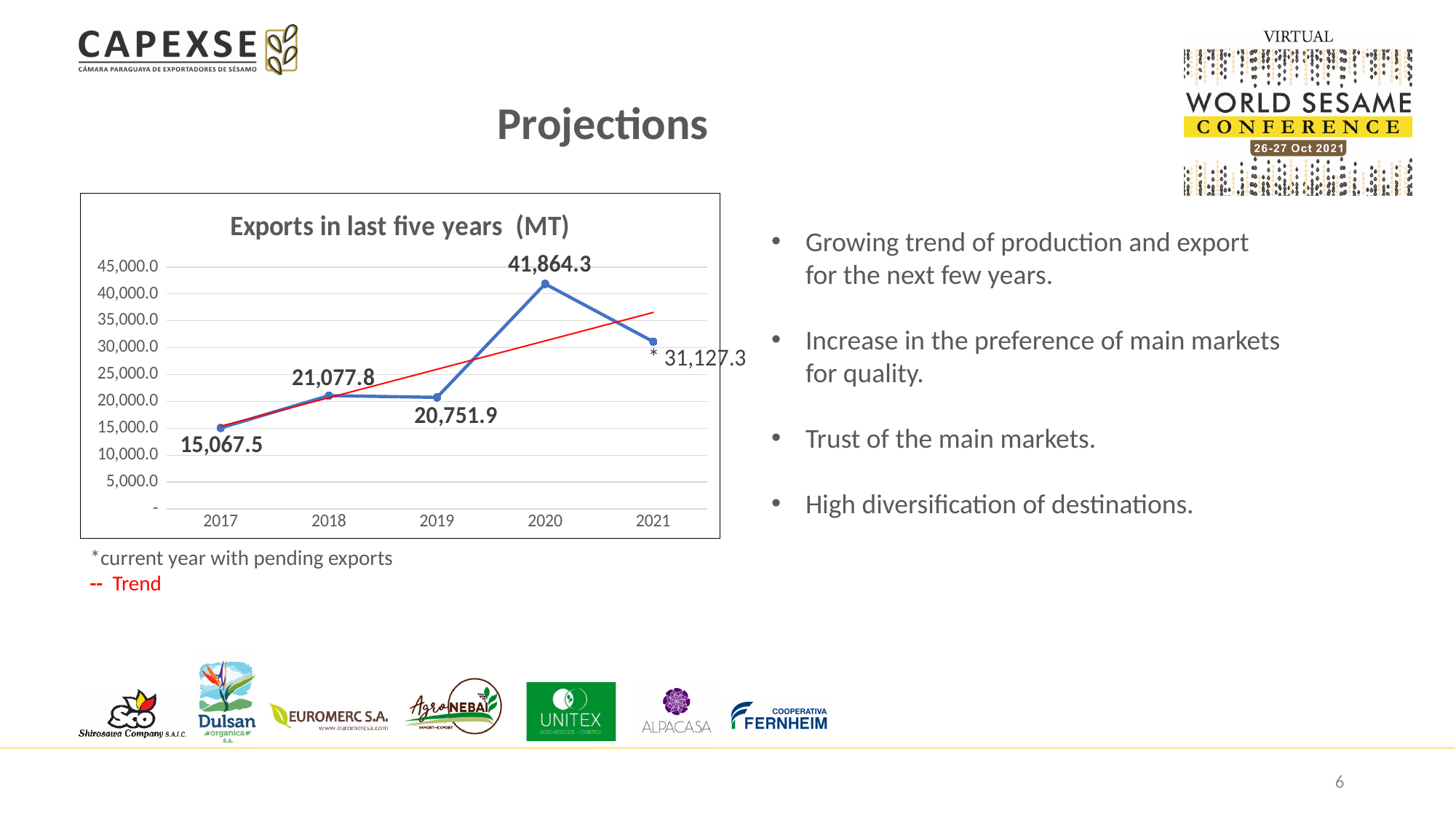
What export value is shown for 2021? 31,127.3 What was the export value in 2017? 15,067.5 Did exports rise or fall from 2020 to 2021? fall Which year had the highest exports? 2020 What type of chart is used to show exports in the last five years? line chart What was the export value in 2020 according to the chart? 41,864.3 Is the export value for 2020 greater or less than 40,000.0? greater Which year had the lowest exports? 2017 By how much did exports increase from 2017 to 2018? 6,010.3 How many years are plotted on the chart? 5 What is the difference between the 2020 and 2019 export values? 21,112.4 Which year had higher exports, 2018 or 2019? 2018